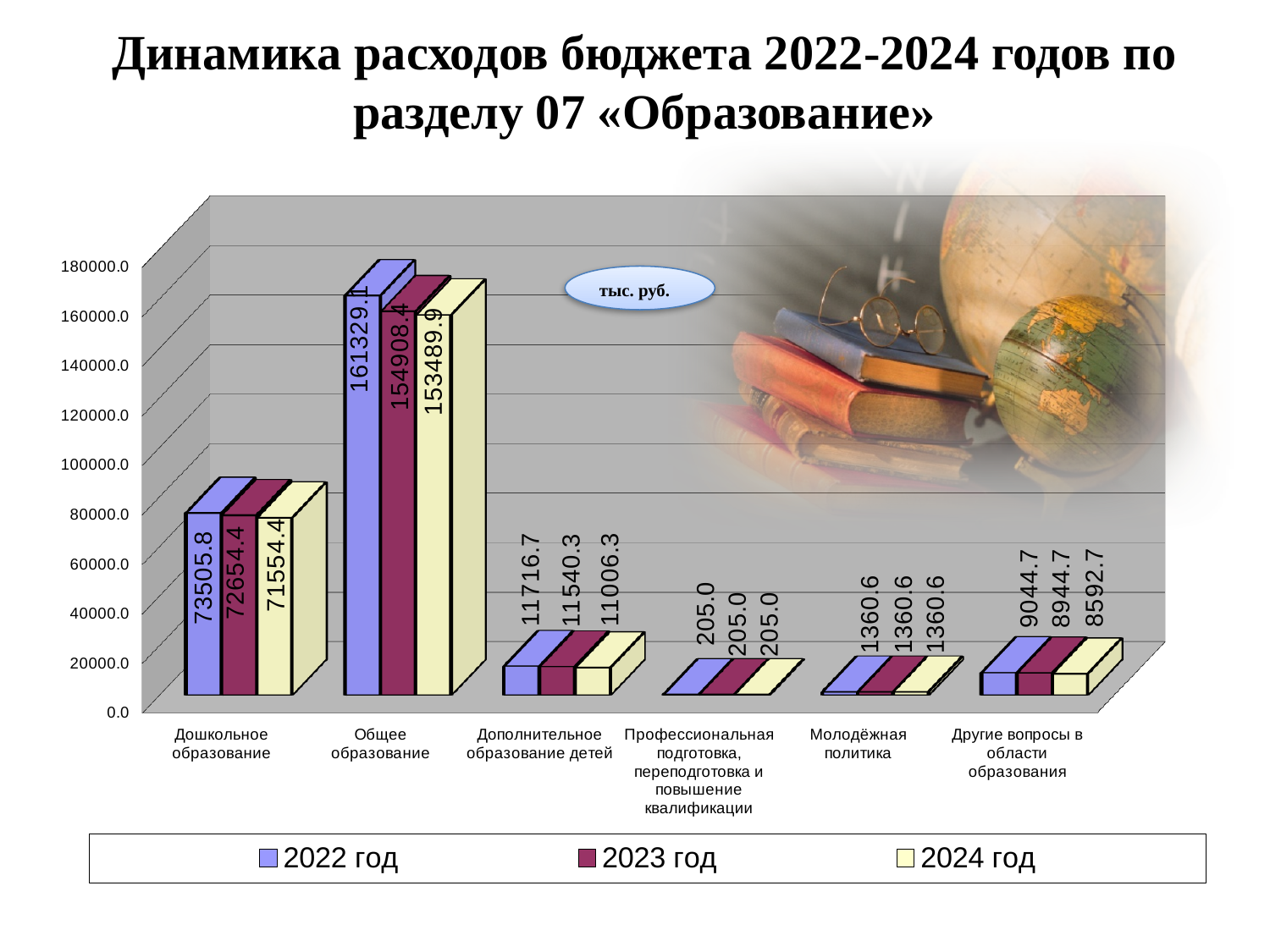
What kind of chart is shown on the slide? Bar chart How many categories are shown on the x axis? 6 Do the values for Дошкольное образование rise or fall from 2022 год to 2024 год? Fall How many series does the legend list? 3 What is the value for Общее образование in 2024 год? 153489.9 Which category has the lowest value in 2024 год? Профессиональная подготовка, переподготовка и повышение квалификации What is the difference between the 2022 год and 2024 год values for Другие вопросы в области образования? 452.0 What is the value for Дошкольное образование in 2022 год? 73505.8 What is the value for Молодёжная политика in 2022 год? 1360.6 What is the value for Дополнительное образование детей in 2023 год? 11540.3 Which is larger: the 2022 год value for Общее образование or the 2023 год value for Общее образование? 2022 год Which category has the highest value in 2022 год? Общее образование